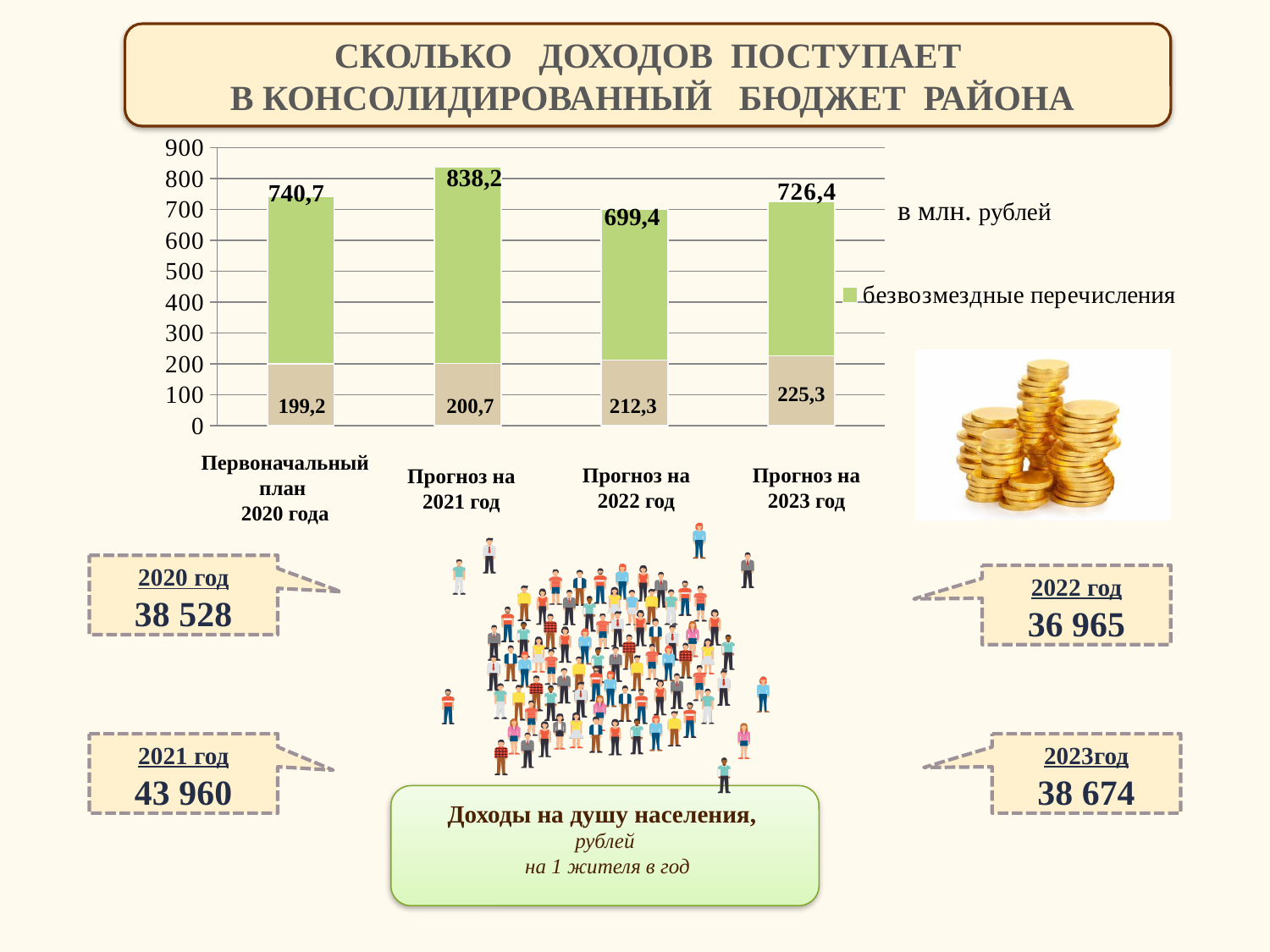
Which category has the tallest bar? Прогноз на 2021 год What is the value printed at the top of the bar for Прогноз на 2021 год? 838,2 Which category has the shortest bar? Прогноз на 2022 год Which is larger: the top value for Первоначальный план 2020 года or for Прогноз на 2023 год? Первоначальный план 2020 года What kind of chart is shown on the slide? bar chart Is the total height of the bar for Прогноз на 2022 год greater or less than 600? greater What is the value printed in the lower (beige) segment of the bar for Прогноз на 2023 год? 225,3 How many categories are shown along the x axis of the chart? 4 What is the difference between the top values printed for Прогноз на 2021 год (838,2) and Первоначальный план 2020 года (740,7)? 97,5 What is the value printed in the lower (beige) segment of the bar for Первоначальный план 2020 года? 199,2 What series name is shown in the chart legend? безвозмездные перечисления How many series does the chart legend list? 1